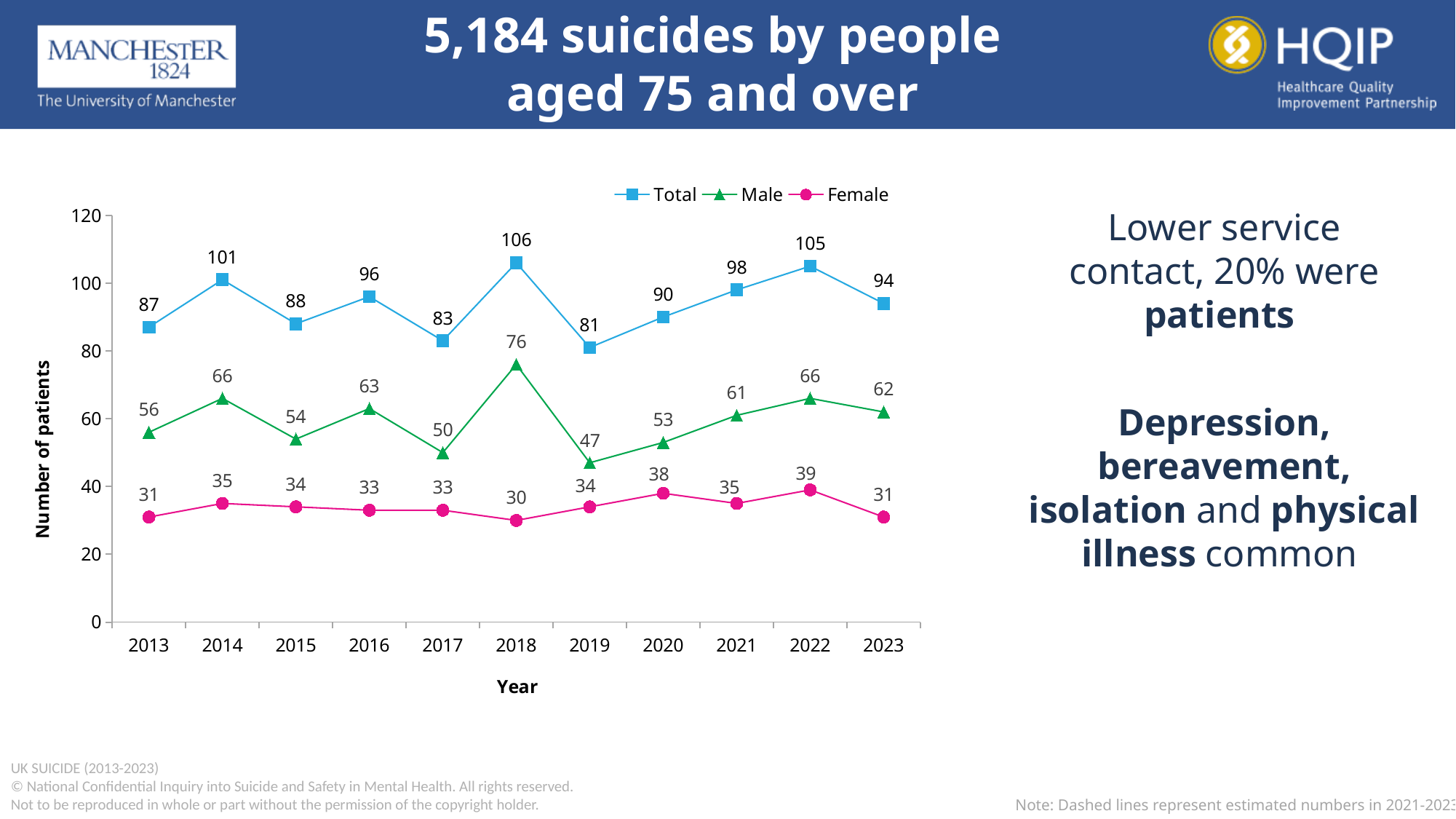
How many years are shown on the x axis? 11 What is the label of the y axis? Number of patients How many series does the legend list? 3 What kind of chart is shown on the slide? line chart Is the Male value for 2018 greater or less than 60? greater What is the Male value for 2019? 47 In which year is the Total series highest? 2018 What is the difference between the Male and Female values in 2023? 31 In which year is the Female series lowest? 2018 What is the Total value for 2018? 106 Which is larger, the Total value in 2014 or the Total value in 2022? 2022 What is the Female value for 2022? 39